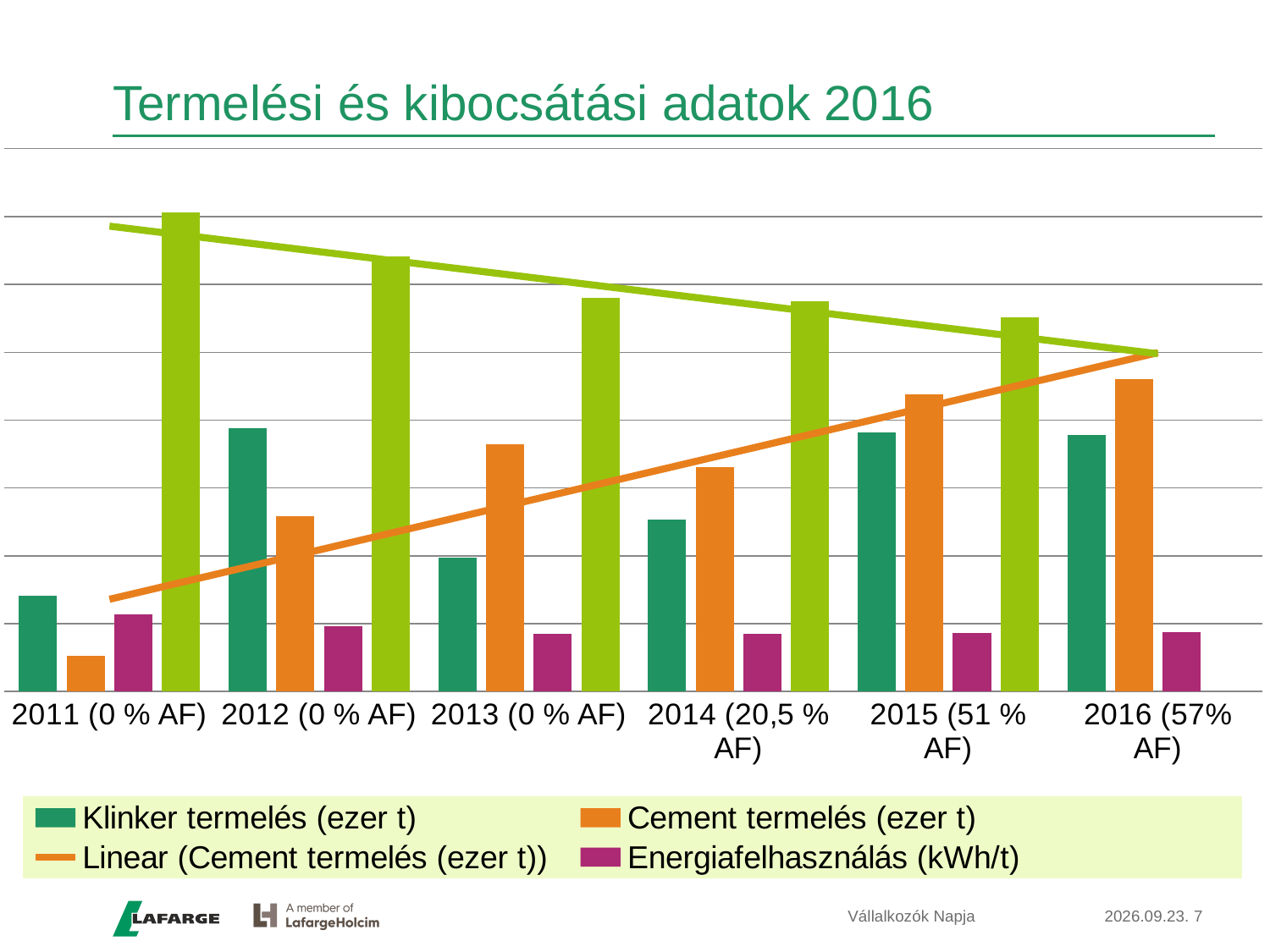
What kind of chart is shown on the slide? bar chart Which year has the lowest Cement termelés (ezer t) bar? 2011 (0 % AF) Which legend entry is drawn as a line rather than bars? Linear (Cement termelés (ezer t)) What is the title of the chart on the slide? Termelési és kibocsátási adatok 2016 How many entries does the chart's legend list? 4 In 2011 (0 % AF), which is larger: Klinker termelés (ezer t) or Cement termelés (ezer t)? Klinker termelés (ezer t) Which is larger: Energiafelhasználás (kWh/t) in 2011 (0 % AF) or in 2013 (0 % AF)? 2011 (0 % AF) In 2014 (20,5 % AF), which is larger: Klinker termelés (ezer t) or Cement termelés (ezer t)? Cement termelés (ezer t) Which year has the highest Cement termelés (ezer t) bar? 2016 (57% AF) How many year categories are shown on the x axis of the chart? 6 Does Cement termelés (ezer t) rise or fall from 2011 to 2016? rise Which year has the lowest Klinker termelés (ezer t) bar? 2011 (0 % AF)